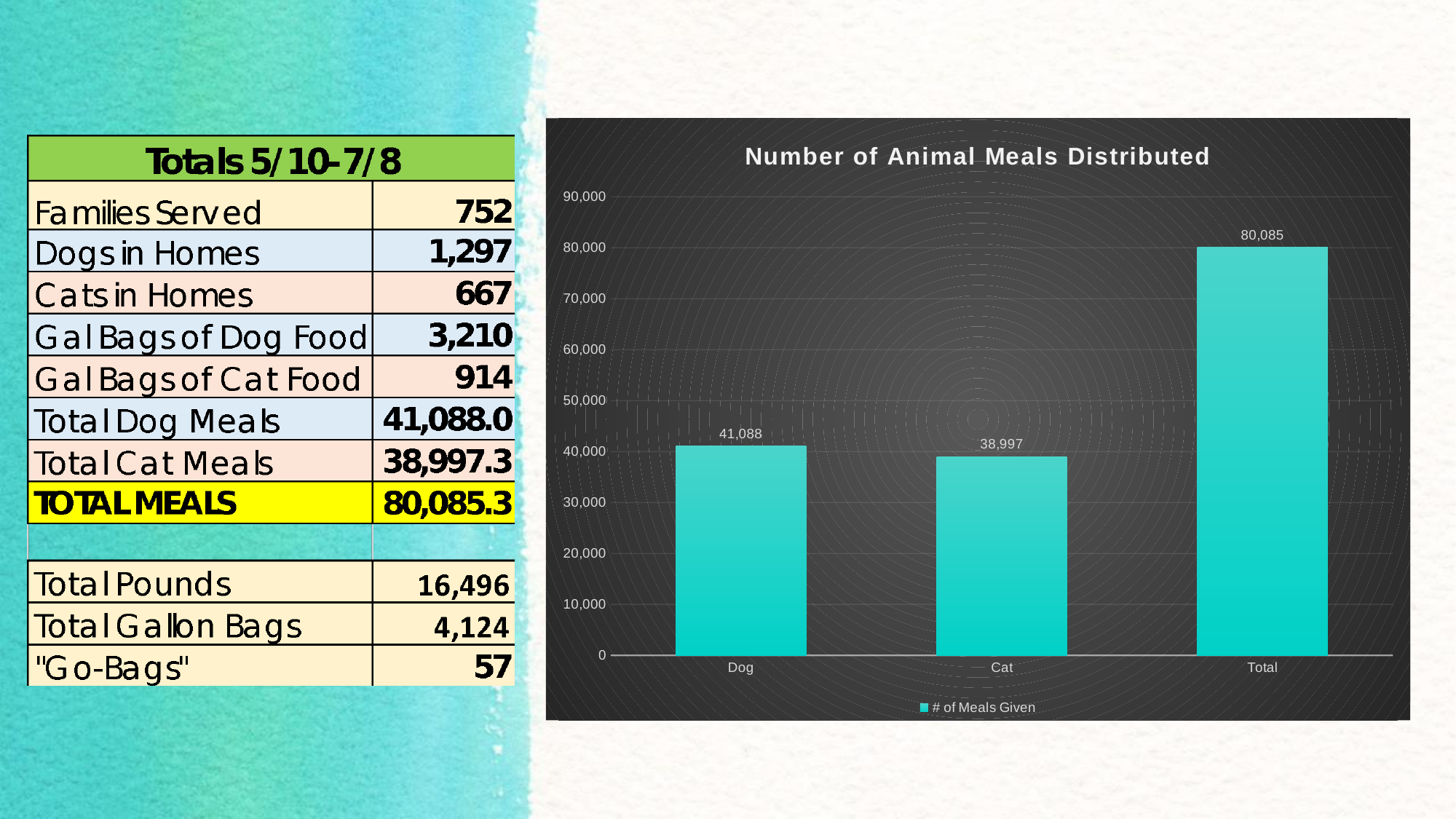
What is the value for Cat in the chart? 38,997 What is the difference between the Dog and Cat values in the chart? 2,091 Is the value for Total greater or less than 70,000? greater Which category has the highest value in the chart? Total Which category has the lowest value in the chart? Cat What is the title of the chart? Number of Animal Meals Distributed What kind of chart is shown on the slide? bar chart How many categories are shown on the x axis of the chart? 3 Which is larger in the chart, the value for Dog or the value for Cat? Dog What is the value for Total in the chart? 80,085 How many series does the chart legend list? 1 What is the value for Dog in the chart? 41,088